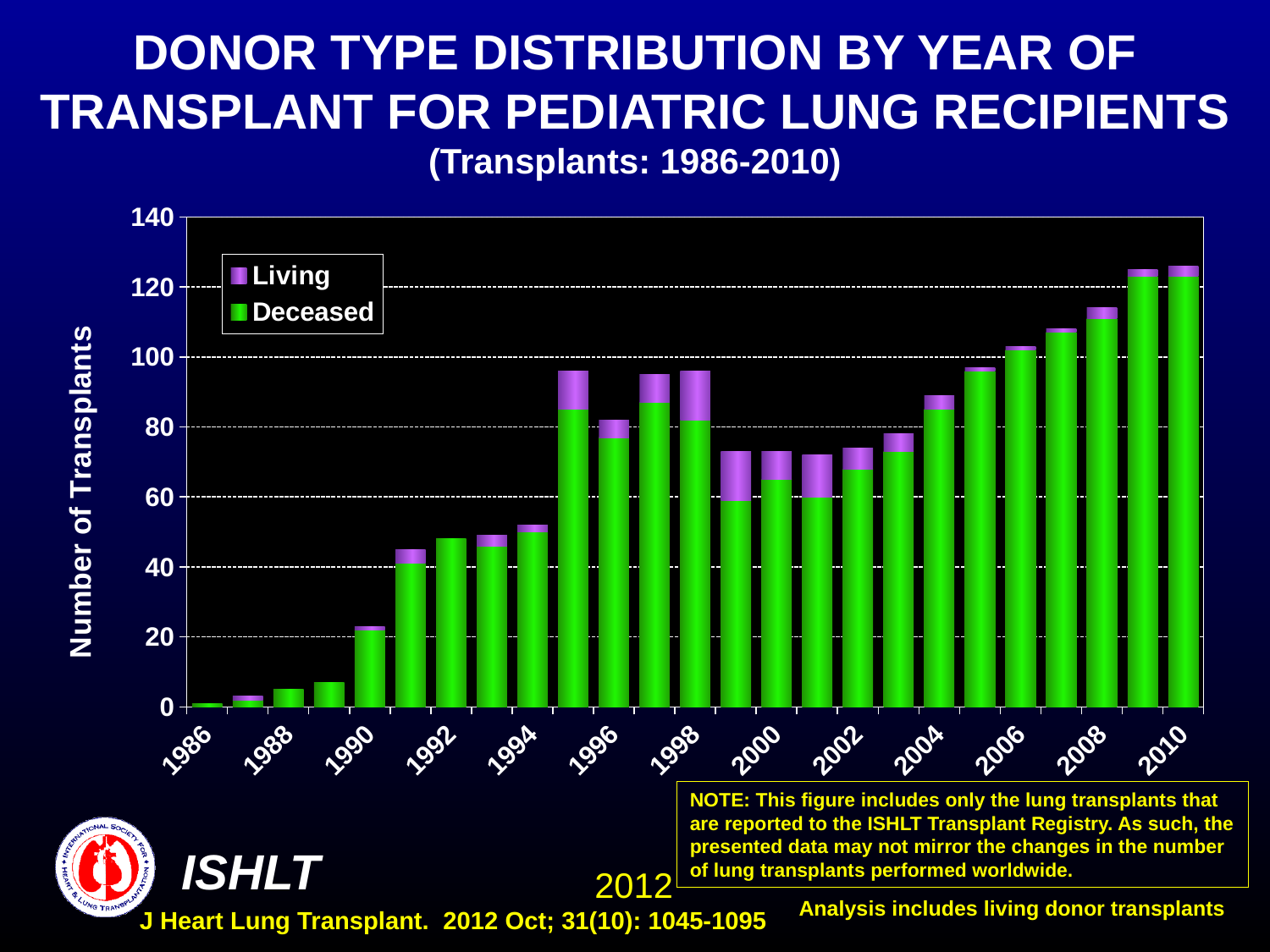
What kind of chart is shown on the slide? bar chart Is the total number of transplants for 2000 greater or less than 80? less How many years (bars) are plotted in the chart? 25 What is the title of the y axis? Number of Transplants Which year has the larger total number of transplants, 2003 or 2004? 2004 Do the total transplant numbers rise or fall from 2001 to 2010? rise How many series does the legend list? 2 Is the total number of transplants for 2010 greater or less than 120? greater Which year has the lowest total number of transplants? 1986 Is the total number of transplants for 1988 greater or less than 20? less Which year has the larger total number of transplants, 1996 or 1997? 1997